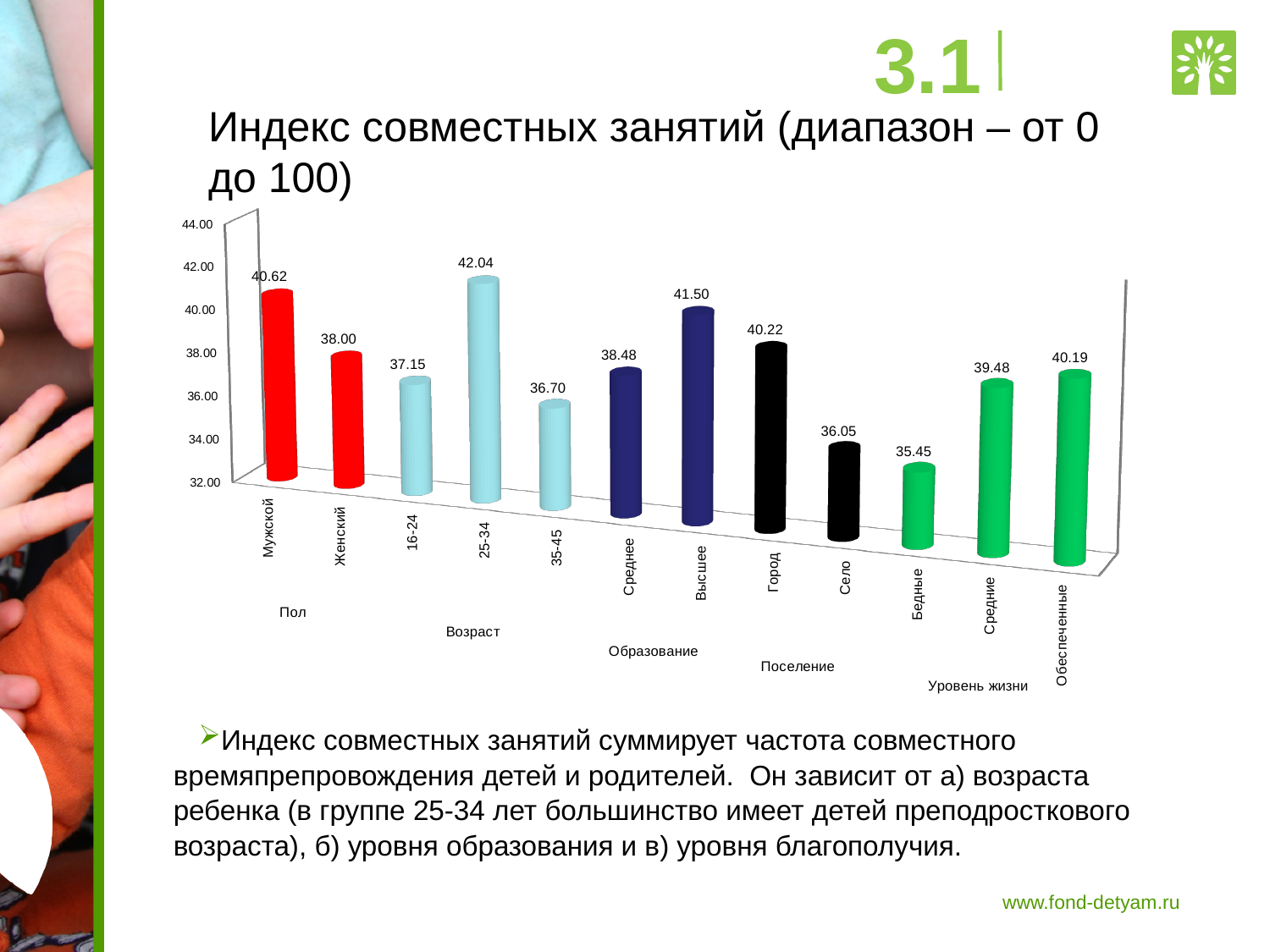
Which is larger, the value for Высшее or the value for Среднее (education)? Высшее What is the value for Село? 36.05 Which category has the highest value? 25-34 What is the difference between the values for Мужской and Женский? 2.62 What is the difference between the values for Город and Село? 4.17 What is the value for the 25-34 age group? 42.04 What type of chart is shown on the slide? Bar chart How many bars are plotted in the chart? 12 Which category has the lowest value? Бедные What is the value for Мужской? 40.62 How many category groups are labelled along the x axis (Пол, Возраст, etc.)? 5 What is the value for Обеспеченные? 40.19